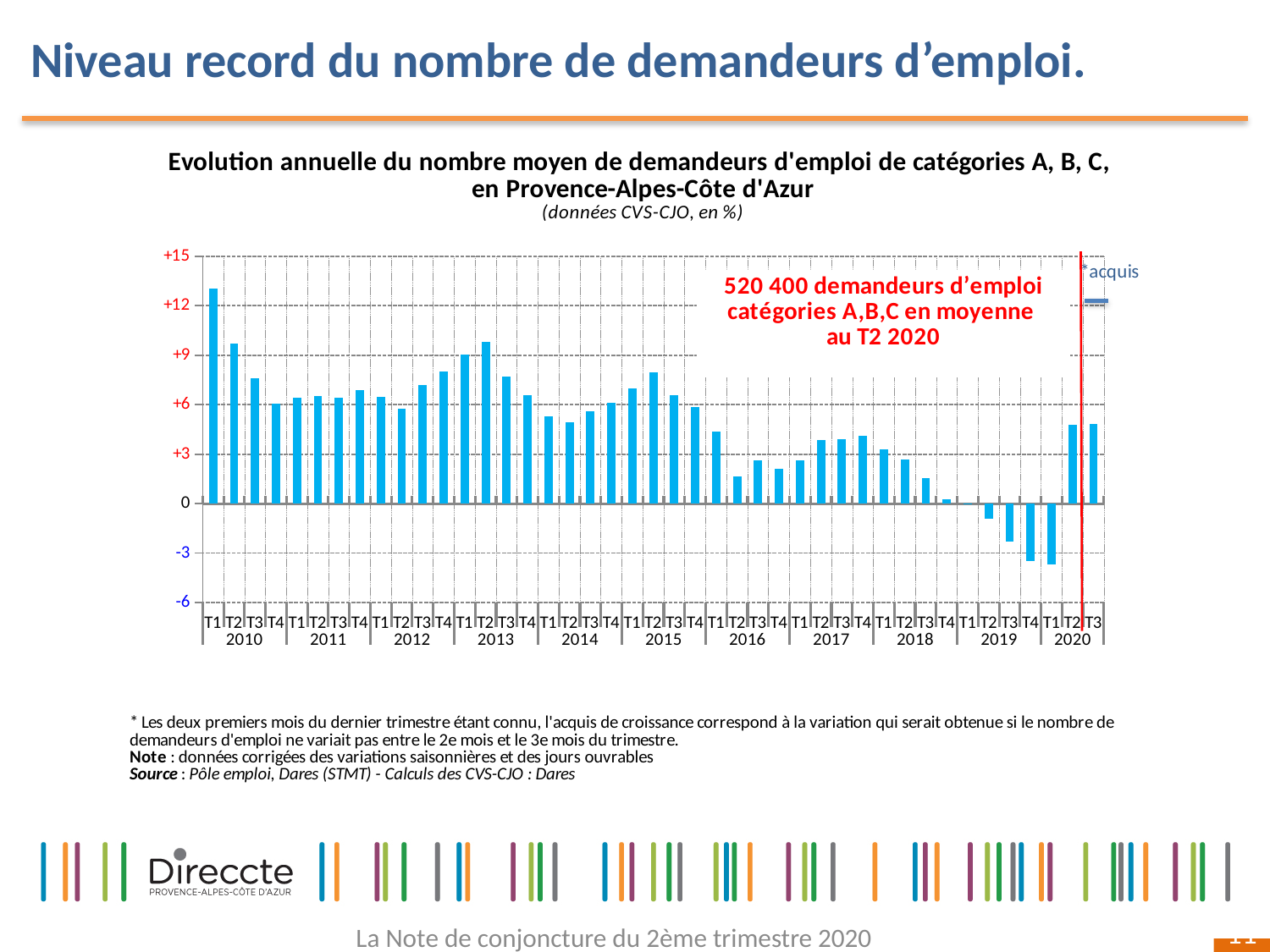
According to the annotation on the chart, what was the average number of job seekers in categories A, B, C in T2 2020? 520 400 Is the value for T1 2010 greater or less than +12? greater Do the values generally rise or fall from T1 2016 to T4 2019? fall How many quarterly bars are plotted in the chart? 43 Is the value for T4 2019 greater or less than -3? less Which is larger, the value for T4 2017 or the value for T4 2018? T4 2017 How many bars in the chart have negative values? 4 Is the value for T2 2020 greater or less than +3? greater Which quarter has the highest value in the chart? T1 2010 What kind of chart is shown on the slide? bar chart Which is larger, the value for T1 2019 or the value for T2 2019? T1 2019